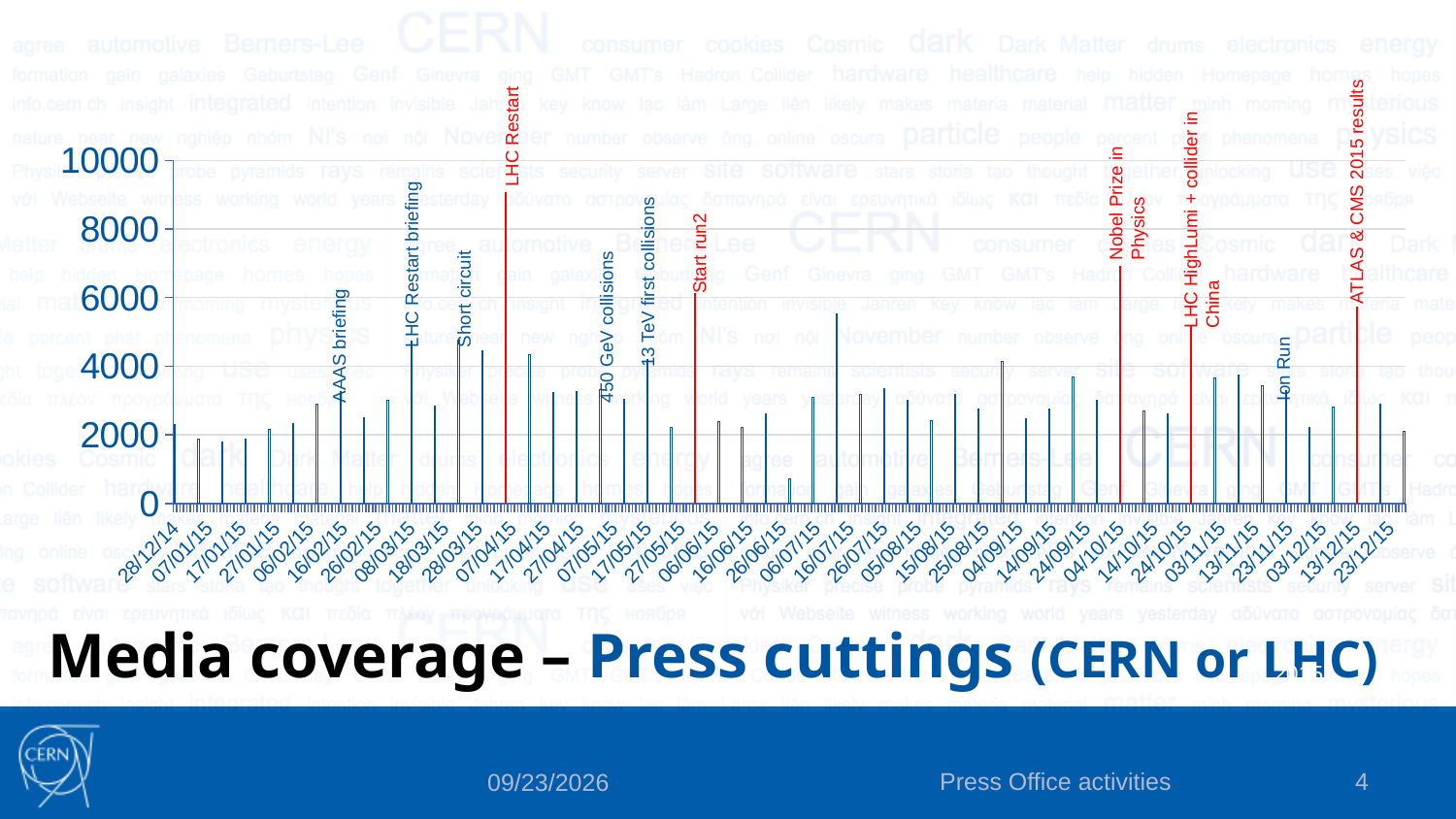
What is the last date shown on the x axis? 23/12/15 Is the value at the Ion Run greater or less than 6000? less What is the highest value shown on the y axis? 10000 What is the title of the slide's chart? Media coverage – Press cuttings (CERN or LHC) Is the value at the LHC Restart greater or less than 6000? greater Is the value at the AAAS briefing greater or less than 6000? less What is the first date shown on the x axis? 28/12/14 What kind of chart is shown on the slide? bar chart Which annotated event has the highest bar in the chart? LHC Restart Is the value at the LHC Restart larger than the value at the Short circuit? yes